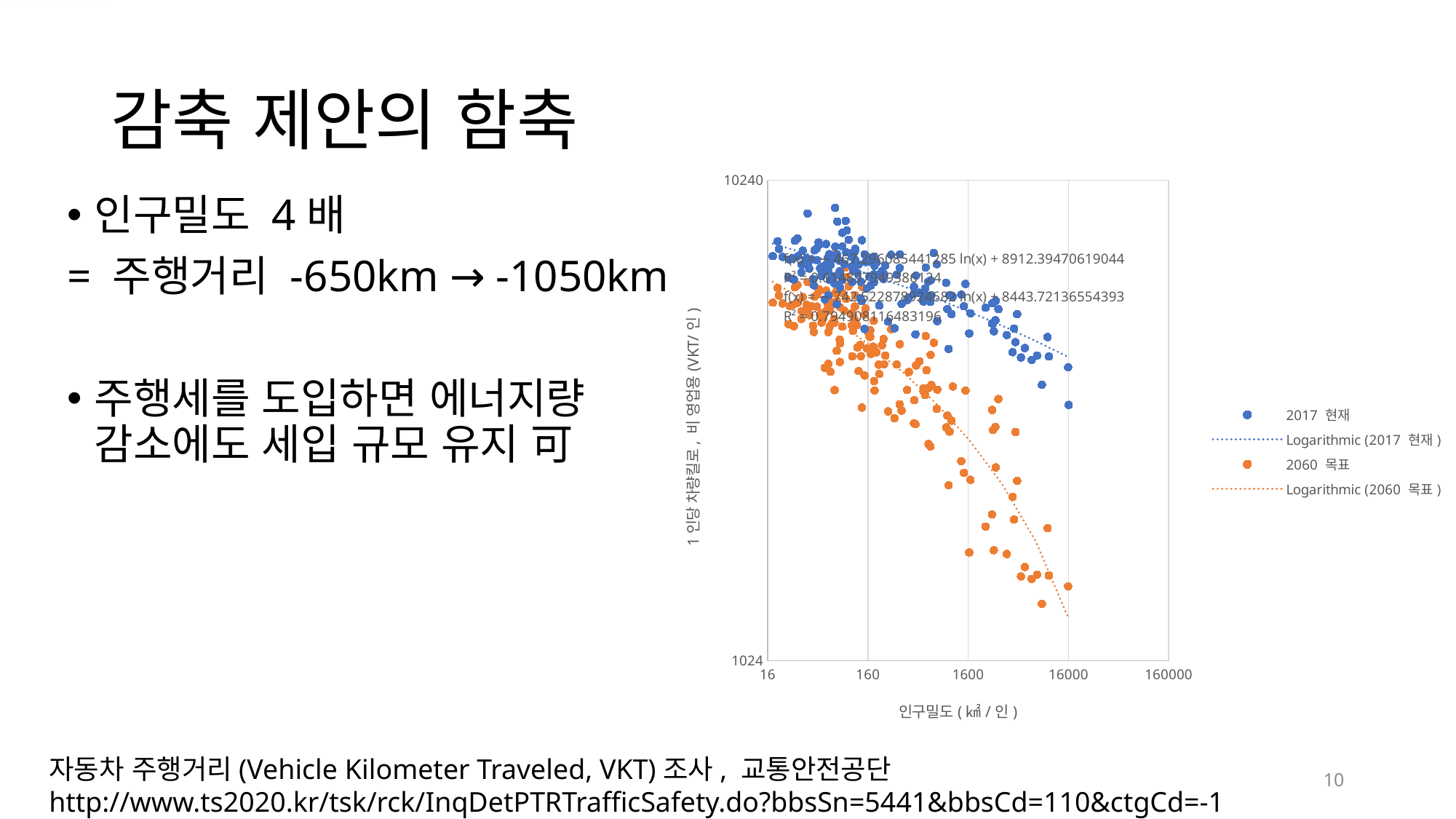
Which series shows the steeper decline along the x axis, 2017 현재 or 2060 목표? 2060 목표 What is the largest tick value shown on the x axis? 160000 Are all the 2017 현재 data points greater or less than 10240 on the y axis? less What kind of chart is shown on the slide? Scatter chart What is the lowest tick value shown on the y axis? 1024 What is the x-axis title of the chart? 인구밀도 ( ㎢ / 인 ) How many data point series (excluding trendlines) are plotted in the chart? 2 At high population density (around 16000 on the x axis), which series has higher values: 2017 현재 or 2060 목표? 2017 현재 What is the highest tick value shown on the y axis? 10240 How many entries does the chart legend list? 4 What are the names of the two data series in the chart legend? 2017 현재 and 2060 목표 As population density (x axis) increases, do the plotted values rise or fall? Fall